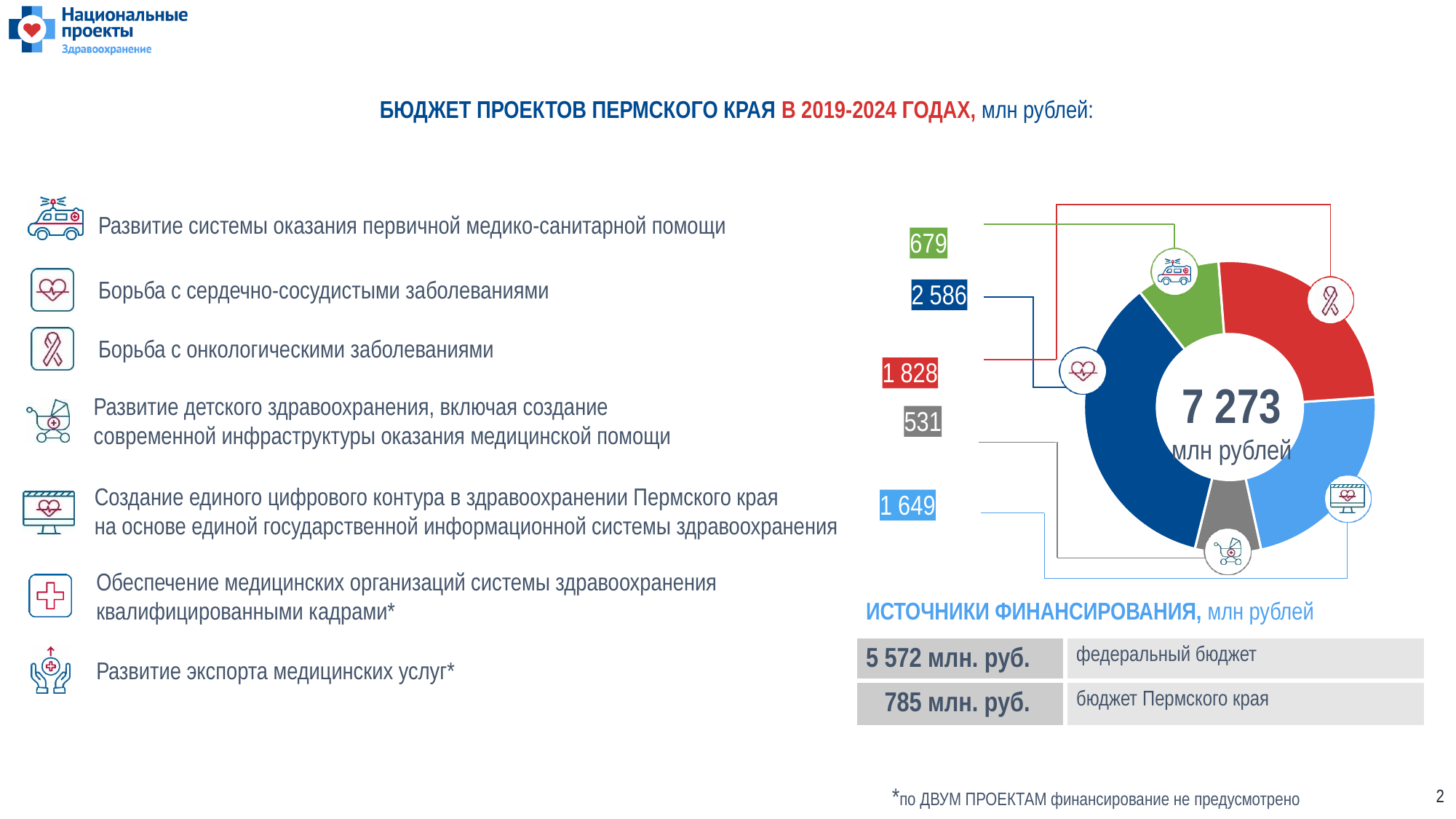
What is the value of the red segment (Борьба с онкологическими заболеваниями)? 1 828 What is the value of the light blue segment (Создание единого цифрового контура)? 1 649 Which is larger: the green segment (679) or the grey segment (531)? The green segment (679) What is the value of the dark blue segment (Борьба с сердечно-сосудистыми заболеваниями)? 2 586 What is the value of the grey segment (Развитие детского здравоохранения)? 531 How many segments does the donut chart have? 5 What type of chart is shown on the slide? Pie (donut) chart Which segment of the donut chart has the largest value? Борьба с сердечно-сосудистыми заболеваниями (2 586) What is the value of the green segment (Развитие системы оказания первичной медико-санитарной помощи)? 679 Which segment of the donut chart has the smallest value? Развитие детского здравоохранения (531) What is the difference between the red segment (1 828) and the light blue segment (1 649)? 179 What is the total value shown in the centre of the donut chart? 7 273 млн рублей